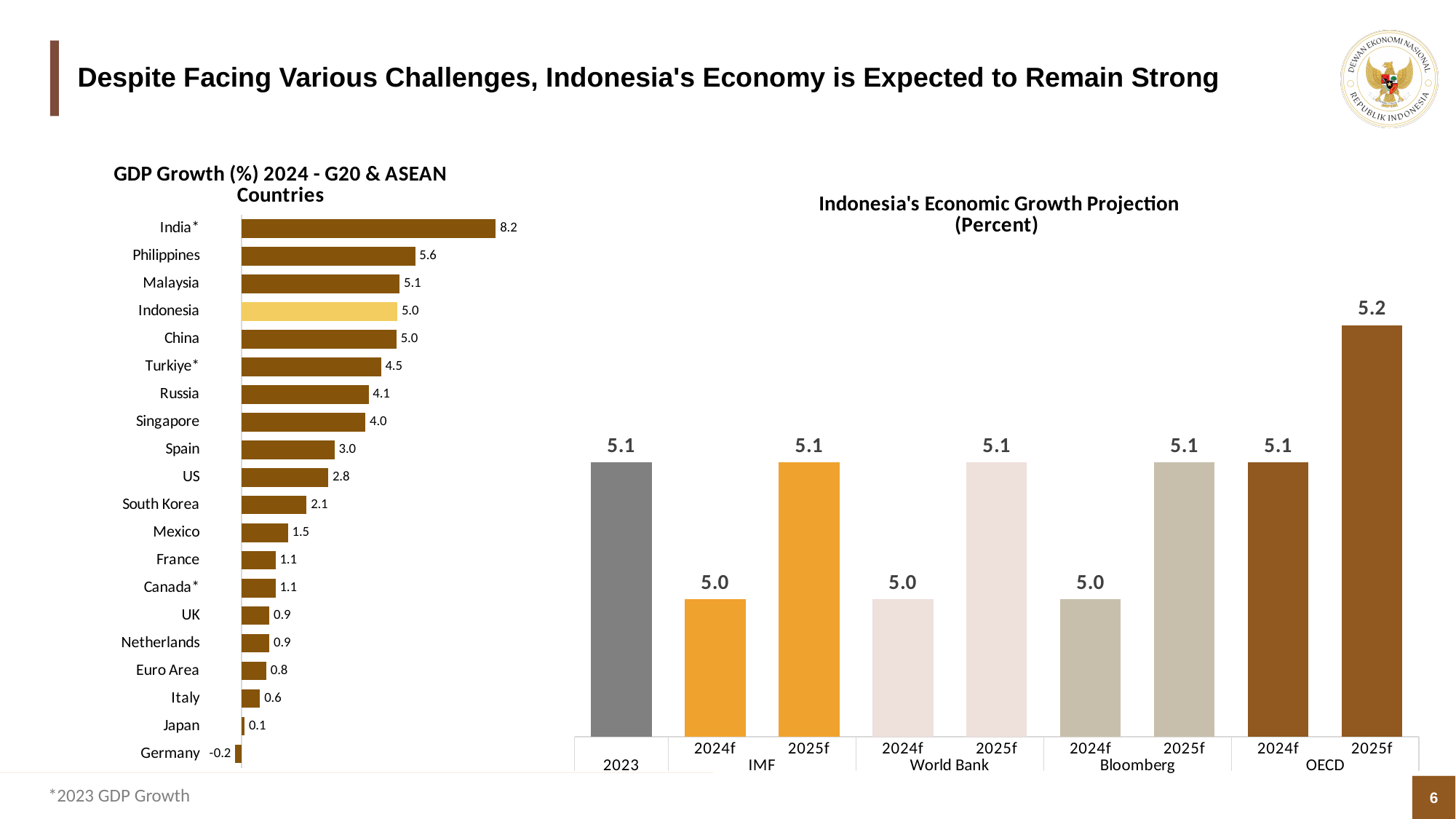
In the 'Indonesia's Economic Growth Projection (Percent)' chart, what is the IMF projection for 2024f? 5.0 What type of chart is the 'Indonesia's Economic Growth Projection (Percent)' chart? Bar chart In the 'Indonesia's Economic Growth Projection (Percent)' chart, what is the difference between the OECD 2025f and OECD 2024f projections? 0.1 In the 'GDP Growth (%) 2024 - G20 & ASEAN Countries' chart, which country has the lowest GDP growth? Germany In the 'Indonesia's Economic Growth Projection (Percent)' chart, which bar has the highest value? OECD 2025f In the 'GDP Growth (%) 2024 - G20 & ASEAN Countries' chart, what is the difference between the values for India* and Philippines? 2.6 In the 'GDP Growth (%) 2024 - G20 & ASEAN Countries' chart, which has a larger value, Russia or Singapore? Russia In the 'GDP Growth (%) 2024 - G20 & ASEAN Countries' chart, which country has the highest GDP growth? India* In the 'Indonesia's Economic Growth Projection (Percent)' chart, what is the OECD projection for 2025f? 5.2 In the 'GDP Growth (%) 2024 - G20 & ASEAN Countries' chart, how many countries or regions are listed? 20 In the 'GDP Growth (%) 2024 - G20 & ASEAN Countries' chart, what is the value for Germany? -0.2 In the 'GDP Growth (%) 2024 - G20 & ASEAN Countries' chart, what is the value for Indonesia? 5.0